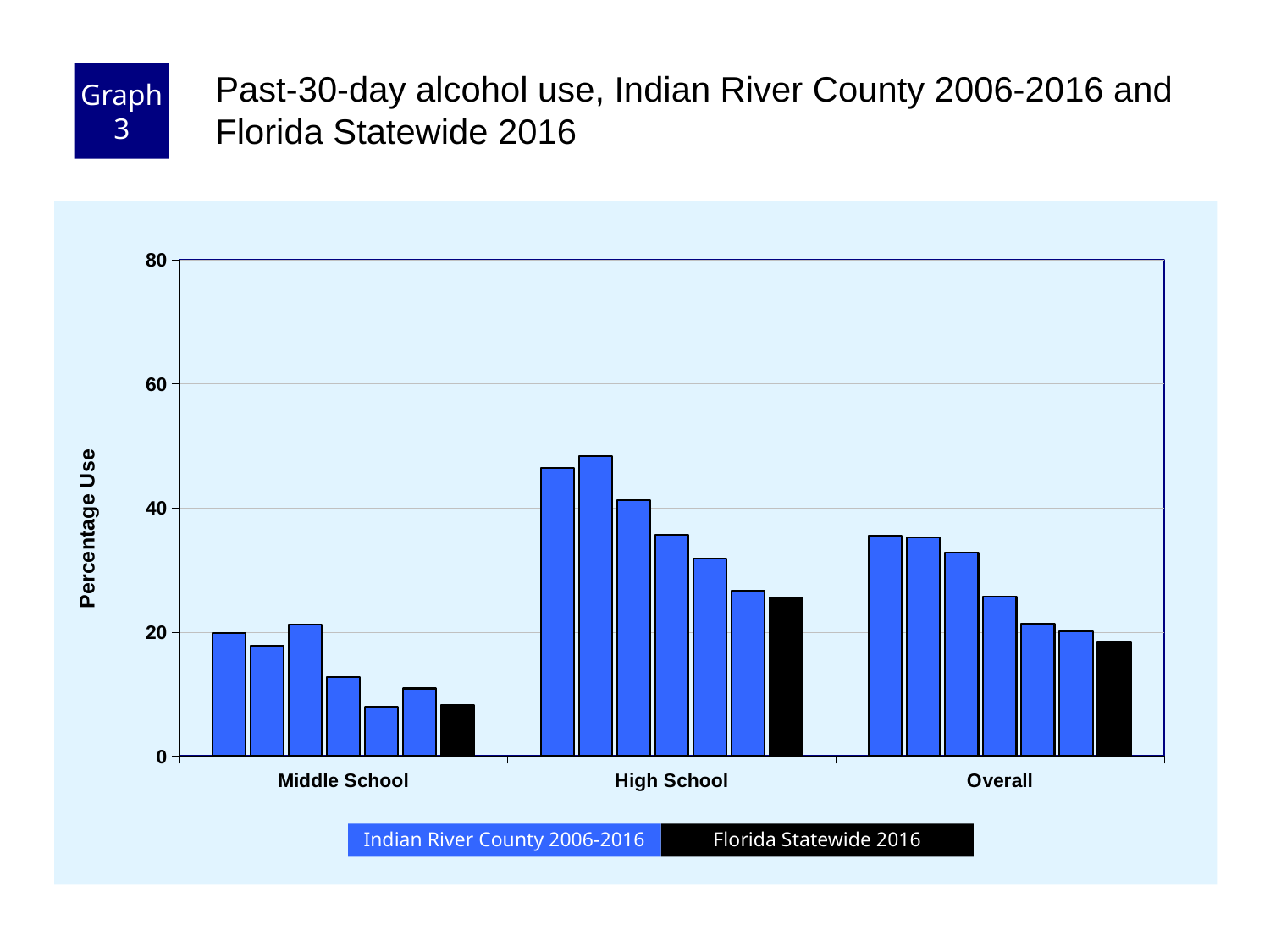
Do the Indian River County 2006-2016 bars in the High School group generally rise or fall from left to right? fall Is the Florida Statewide 2016 value for Middle School greater or less than 20? less How many Indian River County 2006-2016 bars are shown in each category group? 6 Is the tallest Indian River County bar in the High School group greater or less than 40? greater In the High School group, is the Florida Statewide 2016 bar taller or shorter than the tallest Indian River County bar? shorter Which category group has the tallest bars? High School How many school-level categories are shown along the x axis? 3 What is the title of the y axis? Percentage Use Is the Florida Statewide 2016 value for High School greater or less than 20? greater What kind of chart is shown on the slide? bar chart Which category group has the shortest bars? Middle School How many series does the legend list? 2